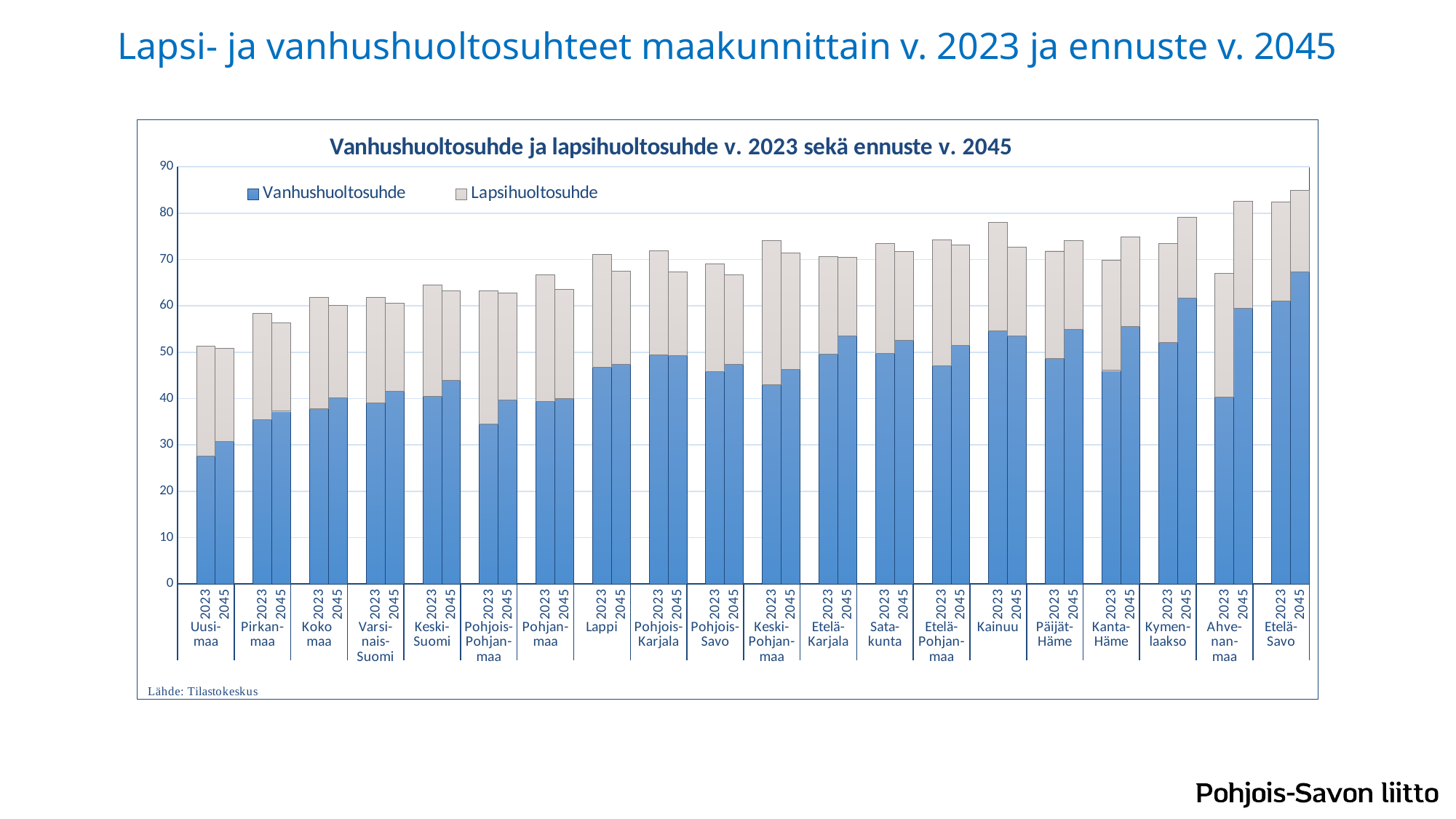
Which region has the lowest Vanhushuoltosuhde value in 2023? Uusimaa How many regions (categories) are shown along the x axis of the chart? 20 Which region has the highest Vanhushuoltosuhde value in 2045? Etelä-Savo How many series does the chart legend list? 2 Is the Vanhushuoltosuhde value for Ahvenanmaa in 2023 greater or less than 50? less Is the Vanhushuoltosuhde value for Etelä-Savo in 2045 greater or less than 60? greater Which region has the lowest total stacked bar (Vanhushuoltosuhde plus Lapsihuoltosuhde)? Uusimaa Which colour represents Vanhushuoltosuhde in the chart legend? Blue Is the total stacked bar for Kainuu in 2023 greater or less than 70? greater What kind of chart is shown on the slide? Stacked bar chart For Ahvenanmaa, which year has the larger Vanhushuoltosuhde value, 2023 or 2045? 2045